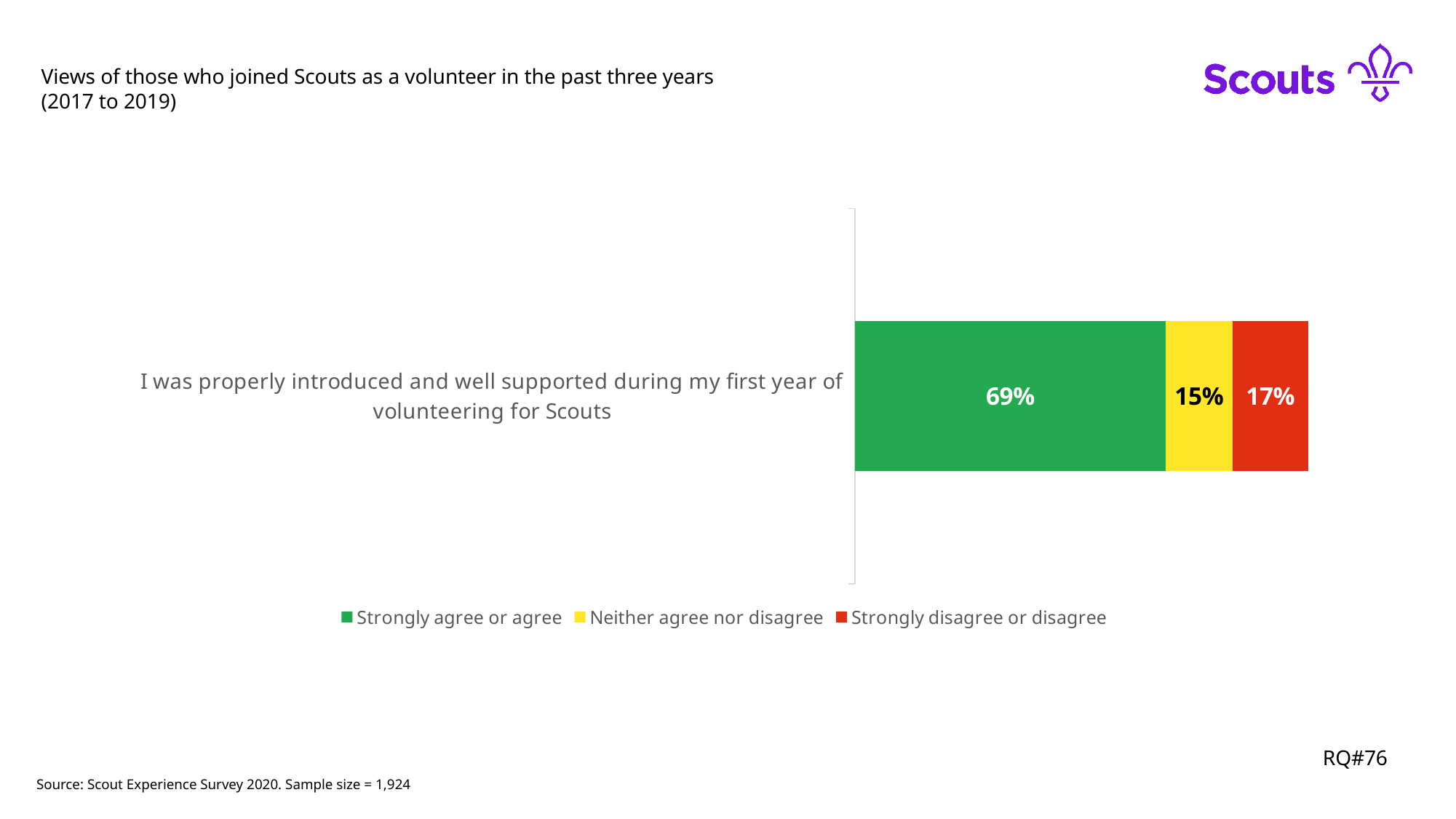
What is the sample size stated in the source note on the slide? 1,924 What is the difference in percentage points between 'Strongly agree or agree' and 'Strongly disagree or disagree'? 52 What percentage of respondents strongly agree or agree that they were properly introduced and well supported during their first year of volunteering for Scouts? 69% What colour represents 'Strongly disagree or disagree' in the chart? Red What kind of chart is shown on the slide? Stacked bar chart How many series does the legend list? 3 Which response category has the largest share for the statement shown? Strongly agree or agree Which response category has the smallest share for the statement shown? Neither agree nor disagree What is the difference in percentage points between 'Strongly disagree or disagree' and 'Neither agree nor disagree'? 2 What percentage of respondents neither agree nor disagree with the statement about being properly introduced and well supported? 15% What percentage of respondents strongly disagree or disagree with the statement about being properly introduced and well supported? 17% Which is larger: the share for 'Strongly agree or agree' or the share for 'Neither agree nor disagree'? Strongly agree or agree